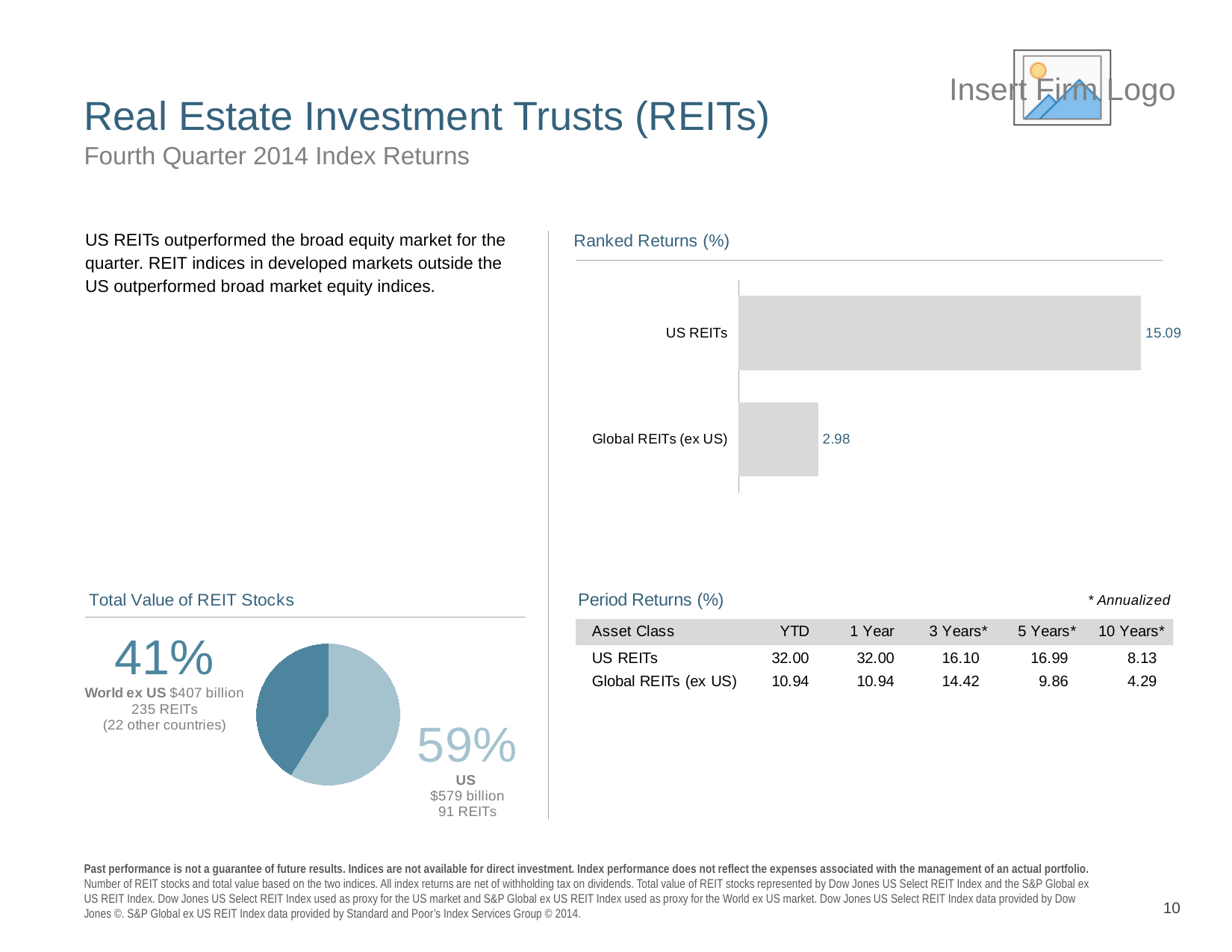
In the Ranked Returns (%) chart, what is the difference between the US REITs value and the Global REITs (ex US) value? 12.11 In the Ranked Returns (%) chart, what is the value for Global REITs (ex US)? 2.98 In the Ranked Returns (%) chart, which category has the highest value? US REITs In the Ranked Returns (%) chart, which category has the lowest value? Global REITs (ex US) In the Ranked Returns (%) chart, what is the value for US REITs? 15.09 In the Total Value of REIT Stocks chart, what share of the pie is US? 59% In the Ranked Returns (%) chart, how many categories are plotted? 2 What kind of chart is the Ranked Returns (%) chart? Bar chart In the Total Value of REIT Stocks chart, what share of the pie is World ex US? 41% In the Total Value of REIT Stocks chart, how many slices does the pie have? 2 In the Total Value of REIT Stocks chart, which slice is larger, US or World ex US? US What kind of chart is the Total Value of REIT Stocks chart? Pie chart